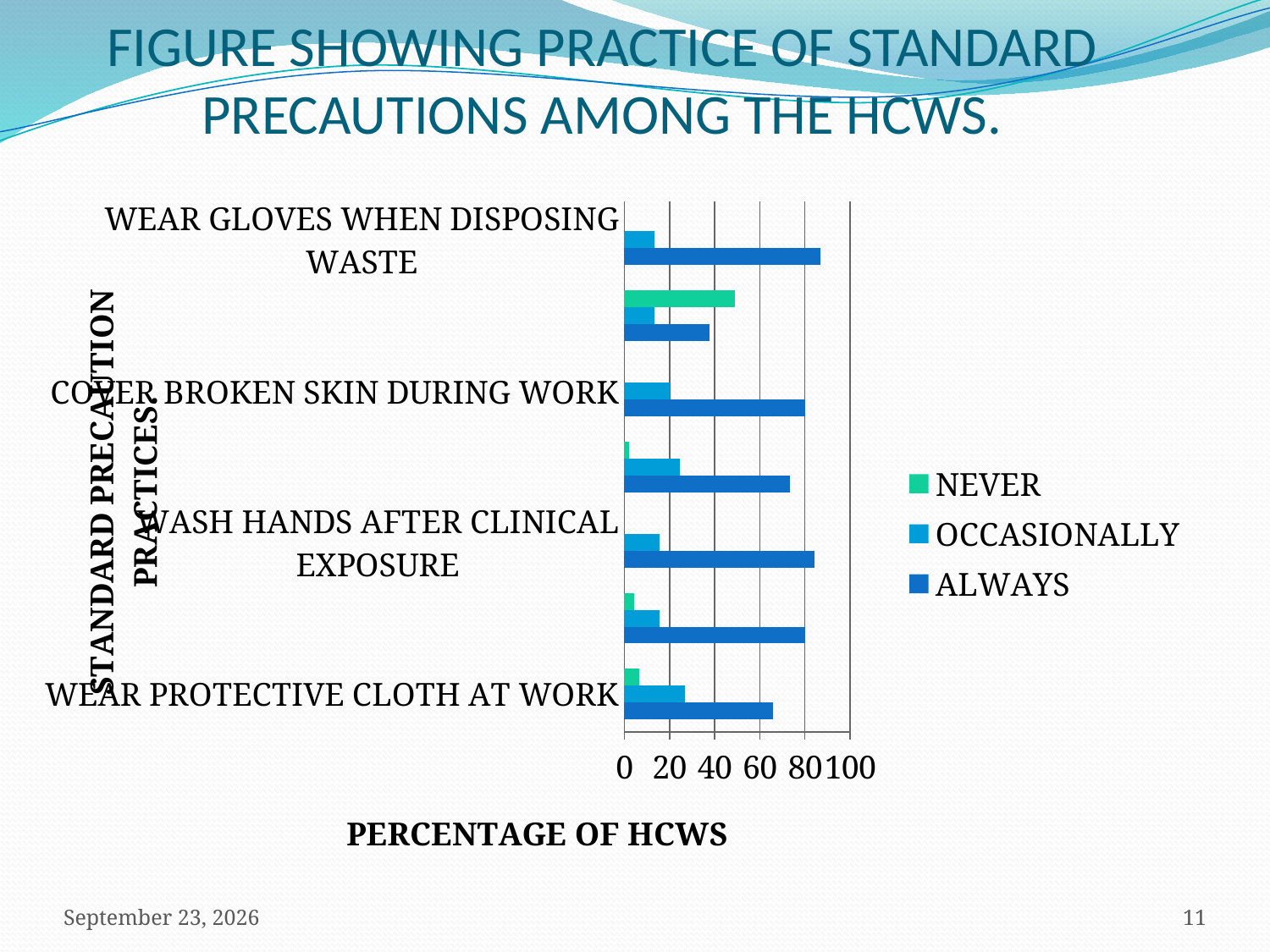
Is the OCCASIONALLY value for COVER BROKEN SKIN DURING WORK greater or less than 40? less For WASH HANDS AFTER CLINICAL EXPOSURE, which is larger: the ALWAYS value or the OCCASIONALLY value? ALWAYS What is the title of the horizontal axis? PERCENTAGE OF HCWS Is the ALWAYS value for WEAR PROTECTIVE CLOTH AT WORK greater or less than 80? less How many series does the legend list? 3 Is the ALWAYS value for WASH HANDS AFTER CLINICAL EXPOSURE greater or less than 60? greater What are the three series named in the legend? NEVER, OCCASIONALLY, ALWAYS Which has the larger OCCASIONALLY value: WEAR PROTECTIVE CLOTH AT WORK or WEAR GLOVES WHEN DISPOSING WASTE? WEAR PROTECTIVE CLOTH AT WORK Among the labelled practices, which has the lowest ALWAYS value? WEAR PROTECTIVE CLOTH AT WORK Which has the larger ALWAYS value: WEAR GLOVES WHEN DISPOSING WASTE or WEAR PROTECTIVE CLOTH AT WORK? WEAR GLOVES WHEN DISPOSING WASTE What kind of chart is shown on the slide? bar chart